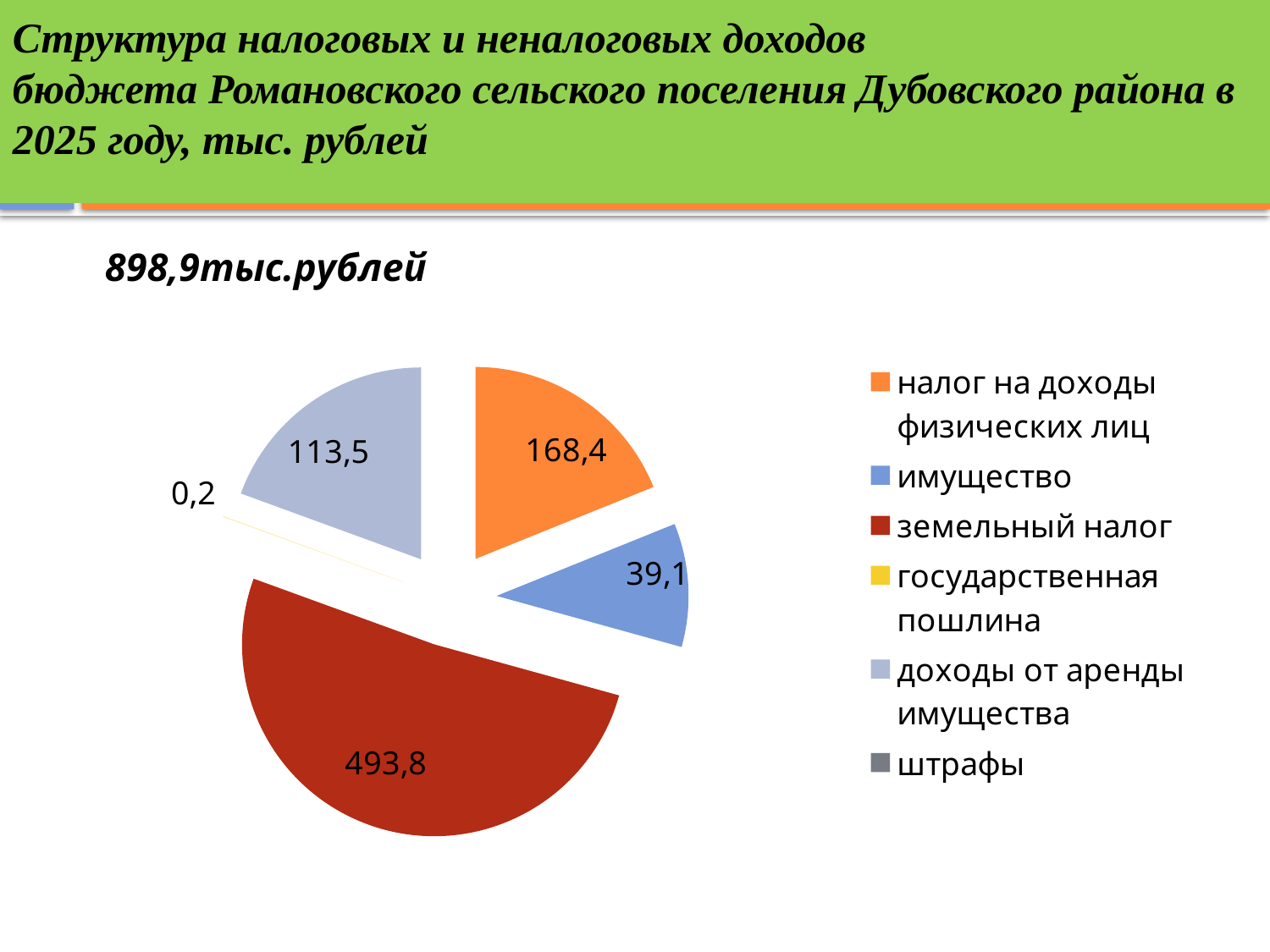
What is the difference between the values for земельный налог and налог на доходы физических лиц? 325,4 What is the value for имущество? 39,1 What is the value for государственная пошлина? 0,2 How many categories does the legend list? 6 What is the value for налог на доходы физических лиц? 168,4 Which labelled category has the smallest value? государственная пошлина Which category has the largest slice of the pie? земельный налог What is the value for земельный налог? 493,8 What type of chart is shown on the slide? pie chart What is the difference between the values for налог на доходы физических лиц and доходы от аренды имущества? 54,9 Which is larger, the value for имущество or the value for доходы от аренды имущества? доходы от аренды имущества What is the value for доходы от аренды имущества? 113,5